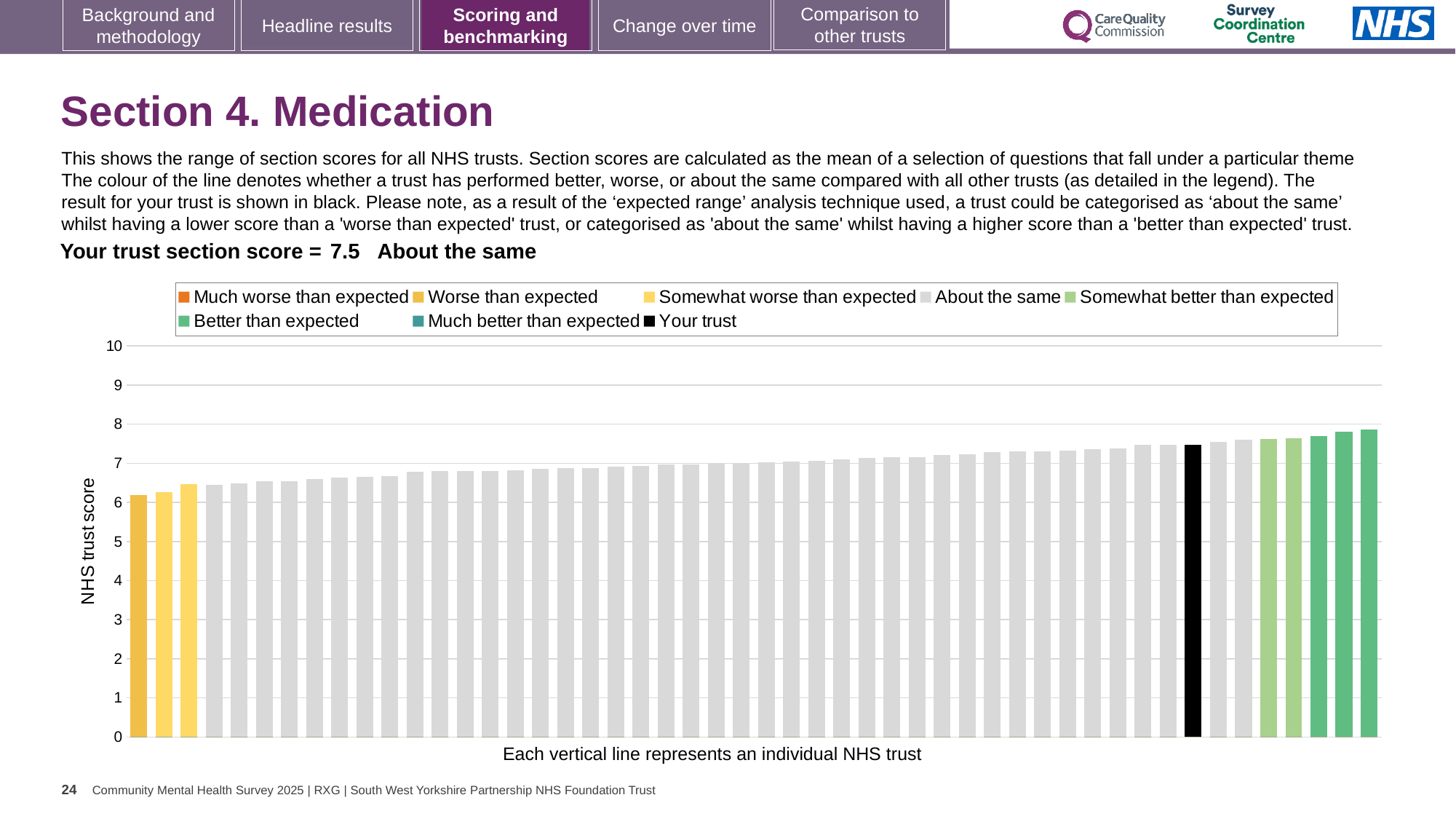
What is the section score for your trust shown on the slide? 7.5 How many entries does the chart legend list? 8 What is the label of the y axis? NHS trust score How many bars are coloured as 'Better than expected'? 3 Is the value of the highest bar greater or less than 8? less How many bars are coloured as 'Somewhat worse than expected'? 2 What colour is the bar for your trust? black What kind of chart is shown on the slide? bar chart Is the value of the highest bar greater or less than 7? greater Is the value of the lowest bar greater or less than 7? less Do the bar values rise or fall from left to right along the x axis? rise